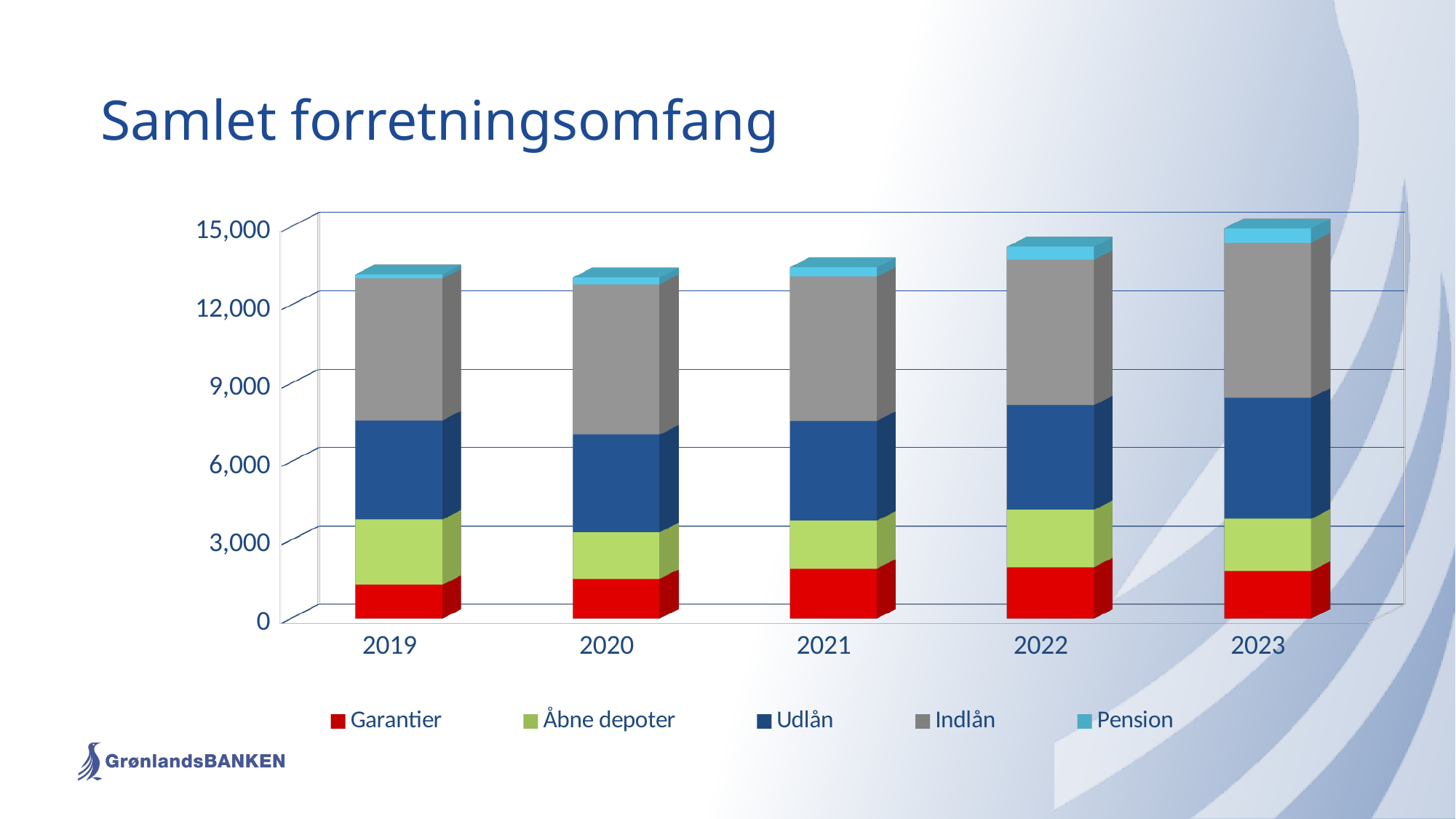
Is the total stacked bar for 2020 greater or less than 9,000? greater Which year has the highest total stacked bar? 2023 Do the total stacked bar heights generally rise or fall from 2019 to 2023? rise Is the Garantier segment for 2019 greater or less than 3,000? less Is the total stacked bar for 2023 greater or less than 12,000? greater How many series does the legend list? 5 What is the title of the chart on the slide? Samlet forretningsomfang Which series is shown in red in the chart? Garantier What kind of chart is shown on the slide? Stacked bar chart How many years are shown on the x axis of the chart? 5 Which year has the larger total stacked bar, 2019 or 2023? 2023